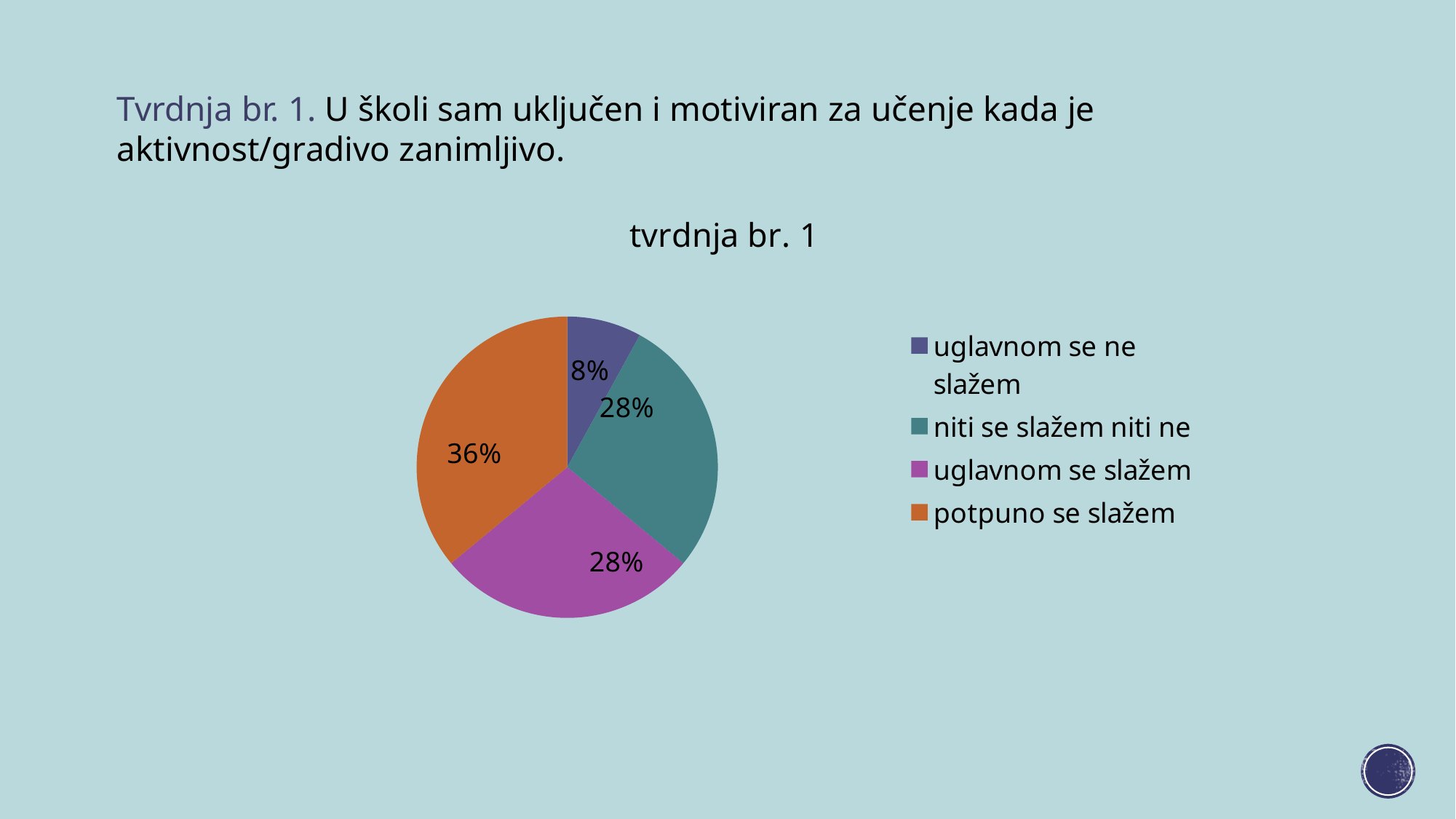
Which category has the largest slice? potpuno se slažem What share of the pie is 'niti se slažem niti ne'? 28% What is the chart's title? tvrdnja br. 1 What share of the pie is 'uglavnom se ne slažem'? 8% What colour is the 'potpuno se slažem' slice? orange Which is larger: the share of 'potpuno se slažem' or the share of 'uglavnom se slažem'? potpuno se slažem What share of the pie is 'uglavnom se slažem'? 28% How many categories does the legend list? 4 What is the difference between the shares of 'potpuno se slažem' and 'uglavnom se ne slažem'? 28% What kind of chart is shown on the slide? pie chart Which category has the smallest slice? uglavnom se ne slažem